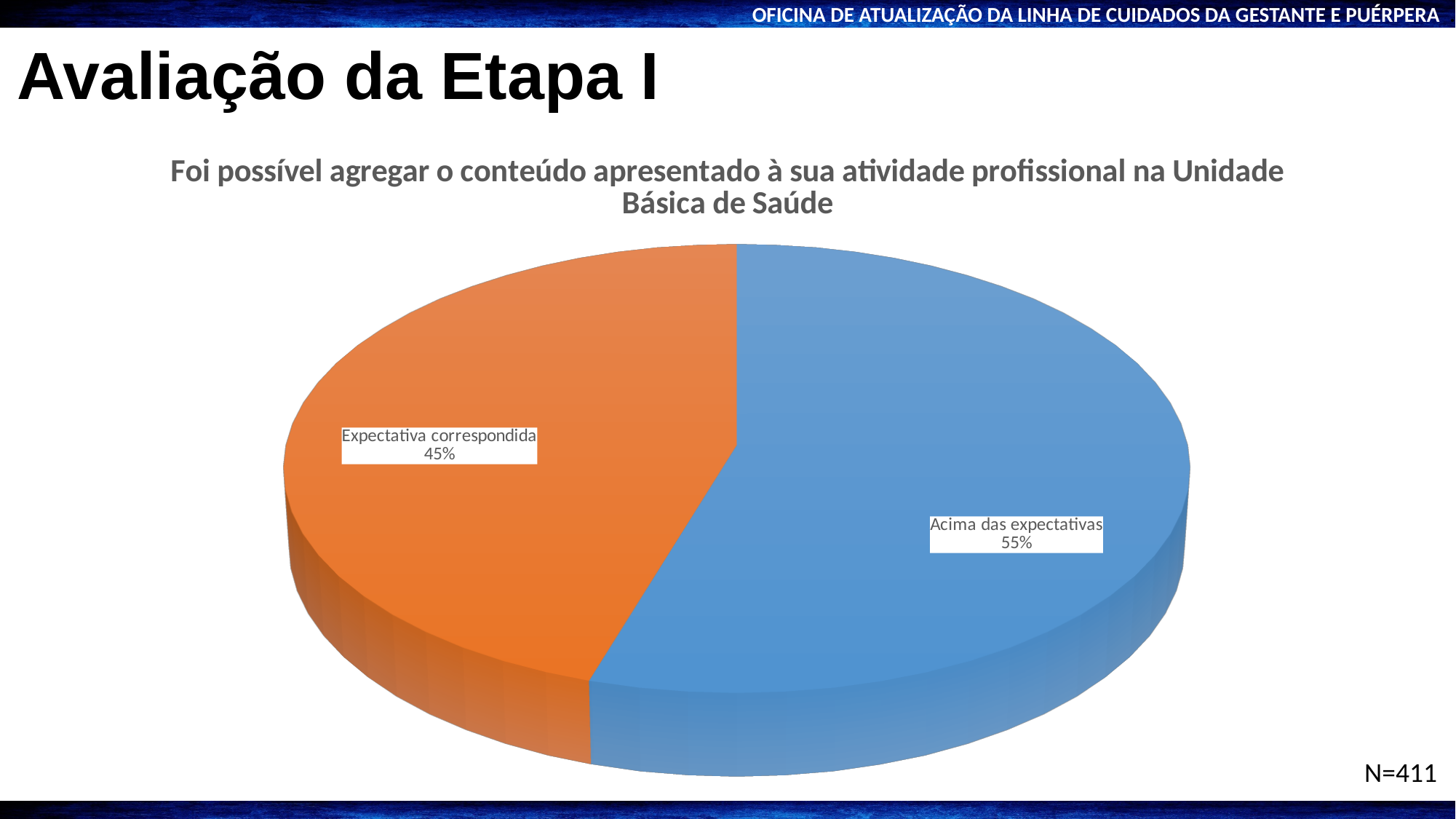
What share of the pie does "Acima das expectativas" represent? 55% What kind of chart is shown on the slide? Pie chart Which slice is the smallest in the pie chart? Expectativa correspondida Which slice is the largest in the pie chart? Acima das expectativas How many slices does the pie chart have? 2 What share of the pie does "Expectativa correspondida" represent? 45% What is the sample size (N) shown on the slide? N=411 Which is larger: "Acima das expectativas" or "Expectativa correspondida"? Acima das expectativas What colour is the "Expectativa correspondida" slice? Orange What is the difference in percentage points between "Acima das expectativas" and "Expectativa correspondida"? 10 percentage points What is the title of the chart? Foi possível agregar o conteúdo apresentado à sua atividade profissional na Unidade Básica de Saúde